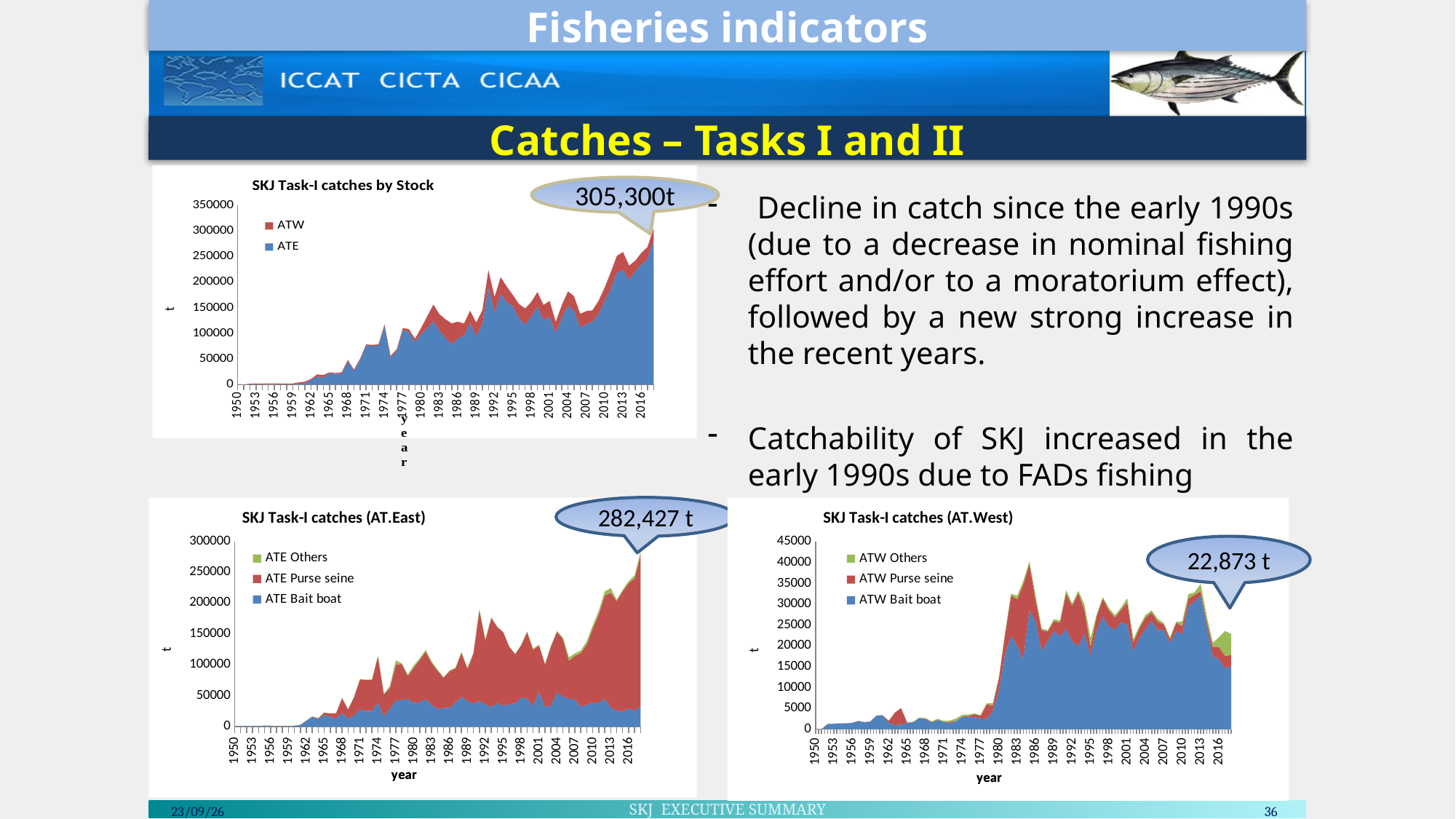
How many series does the legend of the 'SKJ Task-I catches by Stock' chart list? 2 In the 'SKJ Task-I catches (AT.West)' chart, is the total catch in 1983 greater or less than 35000? less What is the x-axis label on the 'SKJ Task-I catches (AT.West)' chart? year How many series does the legend of the 'SKJ Task-I catches (AT.East)' chart list? 3 In the 'SKJ Task-I catches (AT.West)' chart, what value does the callout give for the most recent year? 22,873 t In the 'SKJ Task-I catches (AT.East)' chart, which series accounts for most of the catch in the most recent years, ATE Purse seine or ATE Bait boat? ATE Purse seine What kind of chart is the 'SKJ Task-I catches by Stock' chart? area chart In the 'SKJ Task-I catches by Stock' chart, what value does the callout give for the most recent year? 305,300t What is the difference between the callout value in the 'SKJ Task-I catches (AT.East)' chart and the callout value in the 'SKJ Task-I catches (AT.West)' chart? 259,554 t In the 'SKJ Task-I catches (AT.East)' chart, what value does the callout give for the most recent year? 282,427 t In the 'SKJ Task-I catches by Stock' chart, do the catches generally rise or fall from 1950 to the 1990s? rise Which is larger, the callout value in the 'SKJ Task-I catches (AT.East)' chart or the callout value in the 'SKJ Task-I catches (AT.West)' chart? AT.East (282,427 t)